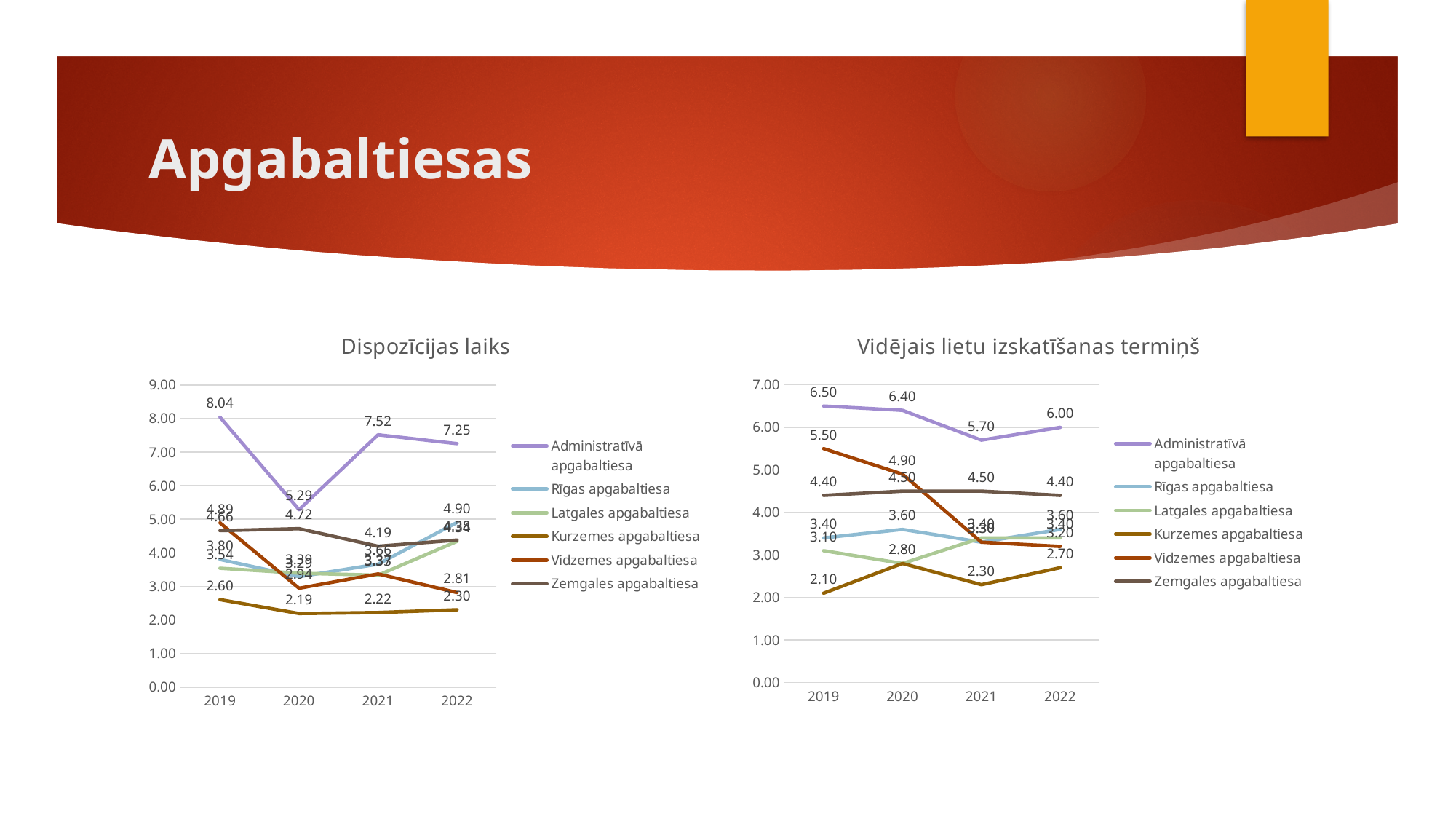
In the 'Dispozīcijas laiks' chart, what is the value for Kurzemes apgabaltiesa in 2020? 2.19 In the 'Dispozīcijas laiks' chart, which court has the lowest value in 2022? Kurzemes apgabaltiesa In the 'Vidējais lietu izskatīšanas termiņš' chart, what is the value for Kurzemes apgabaltiesa in 2019? 2.10 In the 'Dispozīcijas laiks' chart, what is the difference between the Administratīvā apgabaltiesa values for 2019 and 2020? 2.75 How many series does the legend of the 'Dispozīcijas laiks' chart list? 6 In the 'Vidējais lietu izskatīšanas termiņš' chart, what is the value for Vidzemes apgabaltiesa in 2019? 5.50 In the 'Dispozīcijas laiks' chart, which court has the highest value in 2019? Administratīvā apgabaltiesa What kind of chart is the 'Vidējais lietu izskatīšanas termiņš' chart? Line chart In the 'Vidējais lietu izskatīšanas termiņš' chart, is the Administratīvā apgabaltiesa value larger in 2019 or in 2022? 2019 In the 'Dispozīcijas laiks' chart, what is the value for Administratīvā apgabaltiesa in 2020? 5.29 In the 'Dispozīcijas laiks' chart, what is the value for Administratīvā apgabaltiesa in 2019? 8.04 In the 'Vidējais lietu izskatīšanas termiņš' chart, what is the value for Administratīvā apgabaltiesa in 2021? 5.70